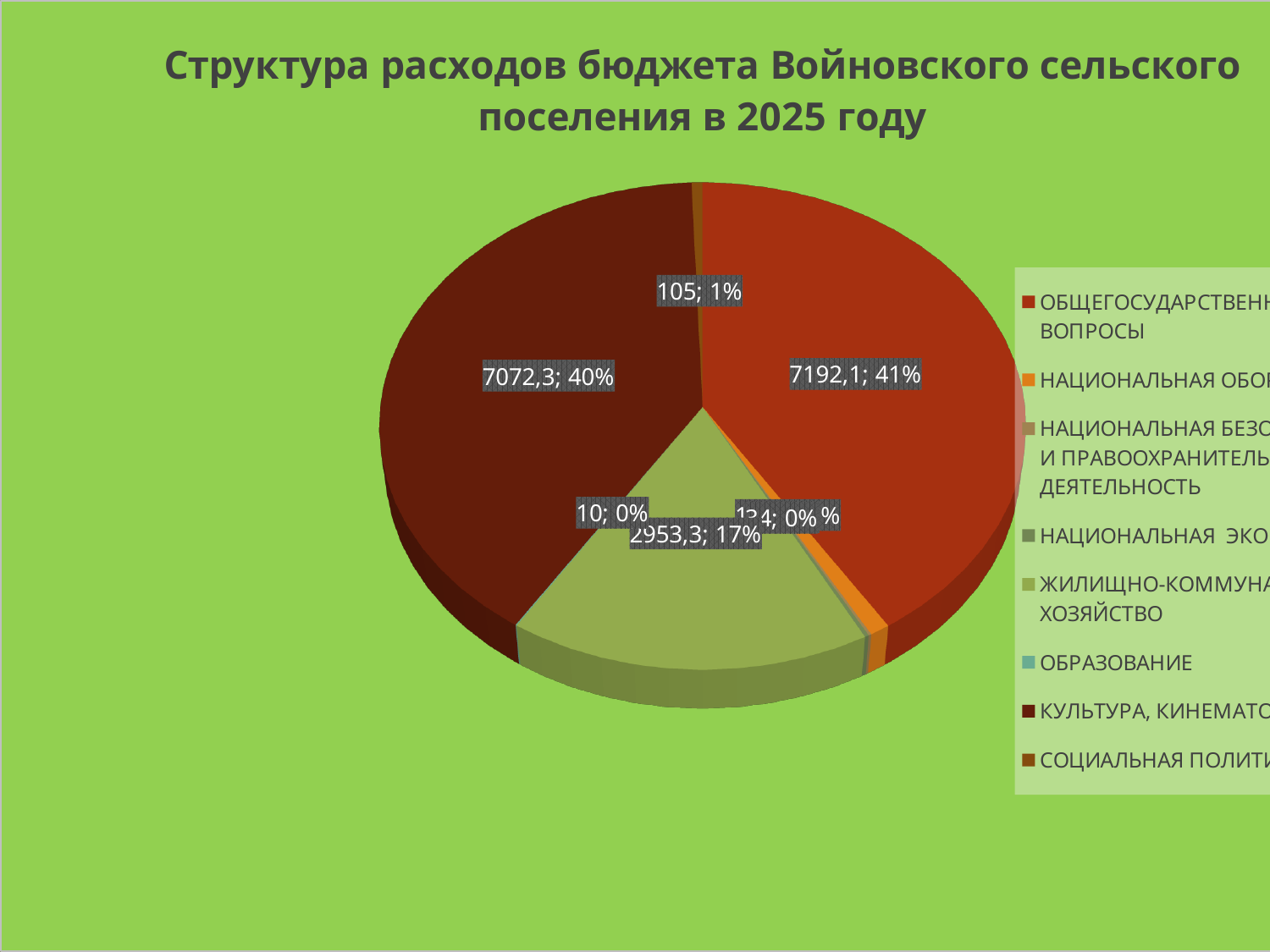
What value and share are labelled on the red slice for ОБЩЕГОСУДАРСТВЕННЫЕ ВОПРОСЫ? 7192,1; 41% Which slice has the largest value? ОБЩЕГОСУДАРСТВЕННЫЕ ВОПРОСЫ (7192,1; 41%) What share of the pie does the orange slice labelled 105 represent? 1% What kind of chart is shown on the slide? pie chart What value and share are labelled on the olive slice for ЖИЛИЩНО-КОММУНАЛЬНОЕ ХОЗЯЙСТВО? 2953,3; 17% What value is labelled on the dark red slice for КУЛЬТУРА, КИНЕМАТОГРАФИЯ? 7072,3 What share of the pie does the slice labelled 7072,3 represent? 40% What is the difference between the values 7192,1 and 7072,3 shown on the pie? 119,8 What is the title of the chart? Структура расходов бюджета Войновского сельского поселения в 2025 году What is the smallest value printed as a data label on the pie? 10 Which is larger: the slice labelled 7192,1 or the slice labelled 7072,3? 7192,1 How many entries does the legend list? 8